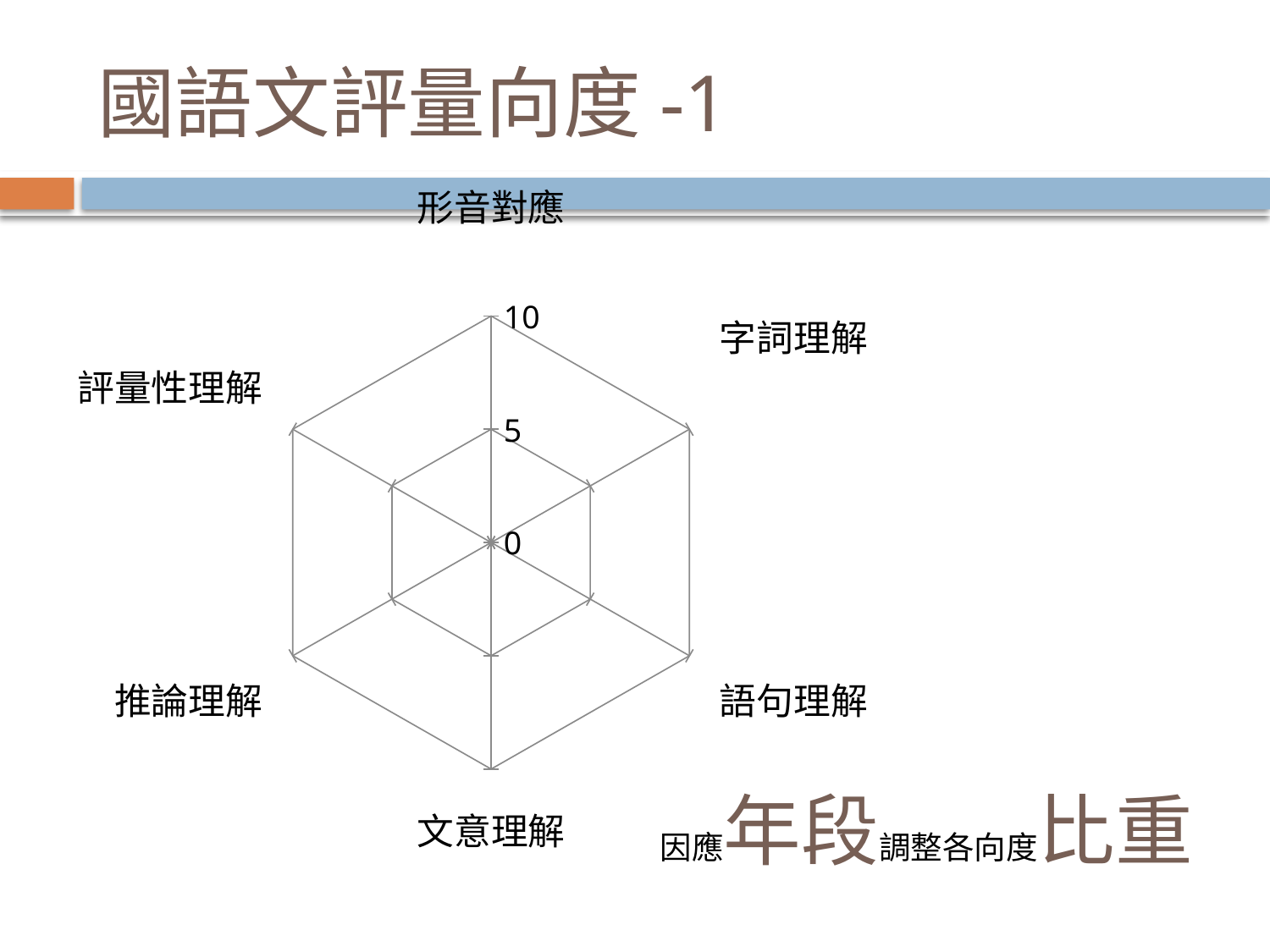
What is the highest value shown on the radar chart's axis scale? 10 What are the tick values printed on the radar chart's axis? 0, 5, 10 What kind of chart is shown on the slide? radar chart How many categories (axes) does the radar chart have? 6 Which category label appears at the top of the radar chart? 形音對應